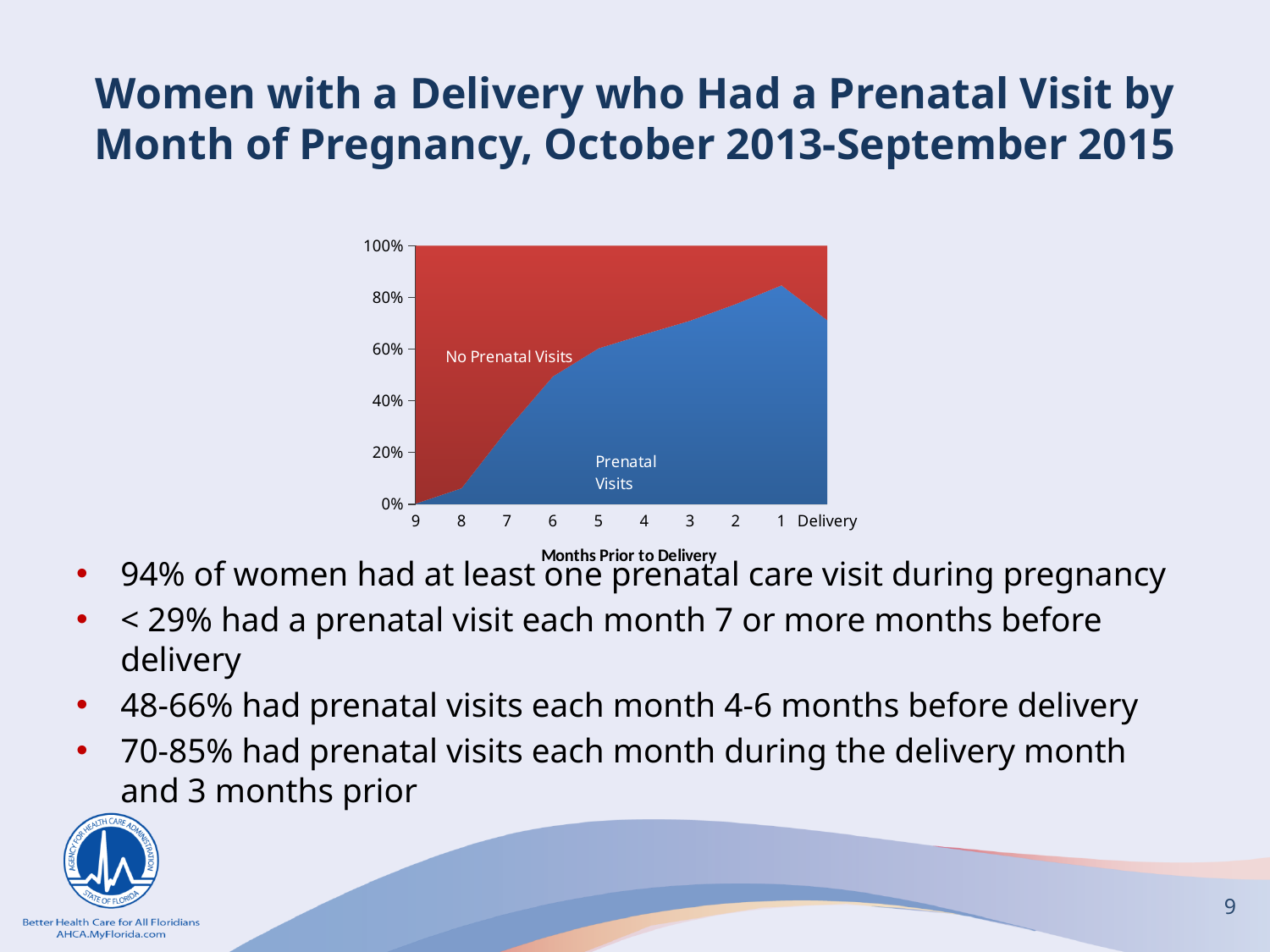
How many points are plotted along the x axis of the chart? 10 Is the Prenatal Visits value at 1 month prior to delivery greater or less than 80%? greater Is the Prenatal Visits value at 6 months prior to delivery greater or less than 40%? greater Is the Prenatal Visits value at 9 months prior to delivery greater or less than 20%? less What kind of chart is shown on the slide? Stacked area chart What is the title of the x axis of the chart? Months Prior to Delivery Which series is shown in red in the chart? No Prenatal Visits Does the Prenatal Visits share rise or fall from 9 months prior to 1 month prior to delivery? rise How many series does the chart show? 2 At which point on the x axis is the Prenatal Visits share highest? 1